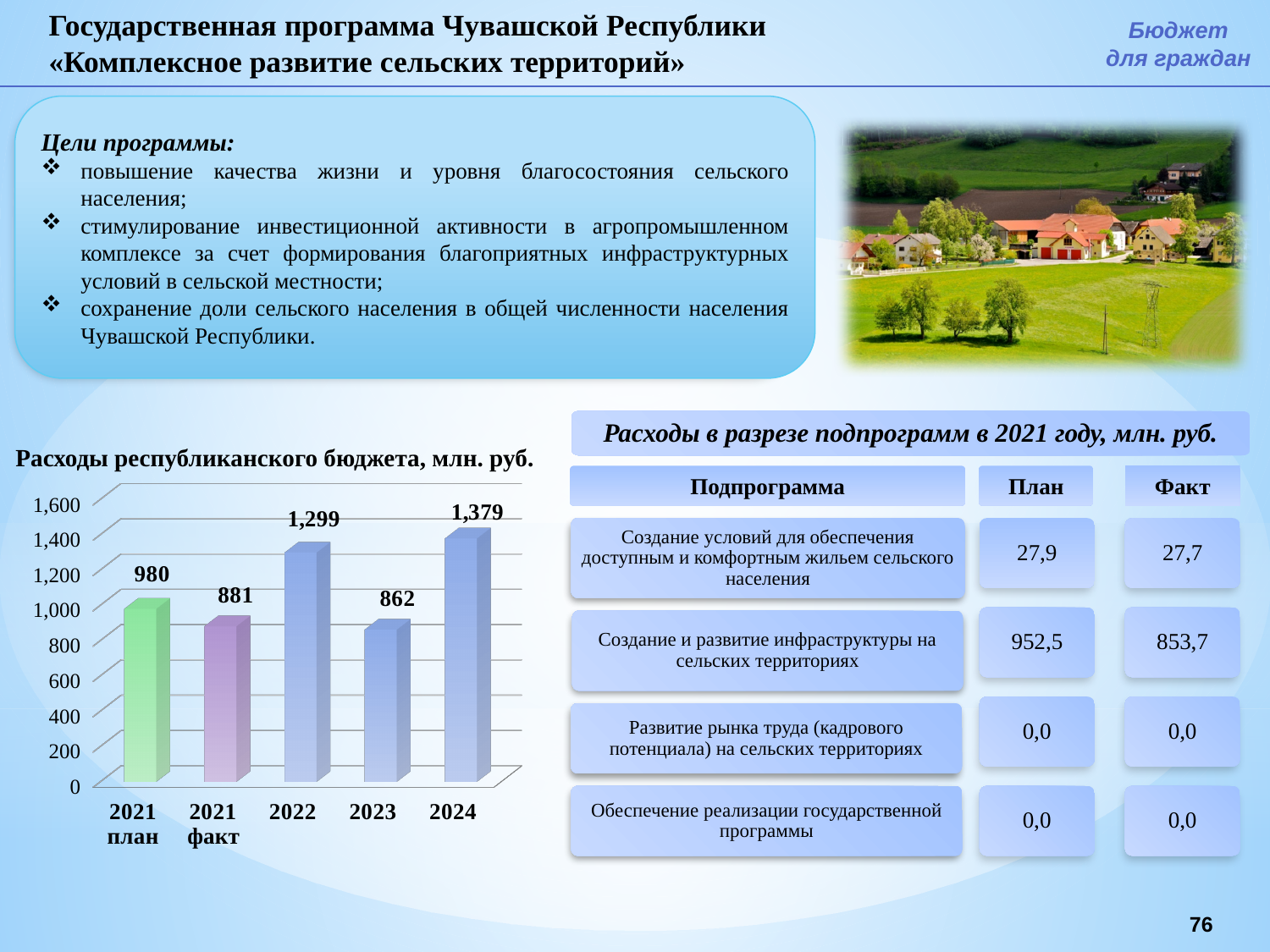
Which category has the highest value in the chart? 2024 Which category has the lowest value in the chart? 2023 Which is larger, the value for 2022 or the value for 2023? 2022 What is the difference between the 2021 план and 2021 факт values? 99 What is the value for 2022 in the chart? 1,299 What is the value for 2021 план in the chart? 980 How many bars are shown in the chart? 5 Is the value for 2023 greater or less than 1,000? less What is the value for 2021 факт in the chart? 881 What type of chart is shown on the slide? bar chart What is the value for 2024 in the chart? 1,379 What is the title of the chart? Расходы республиканского бюджета, млн. руб.